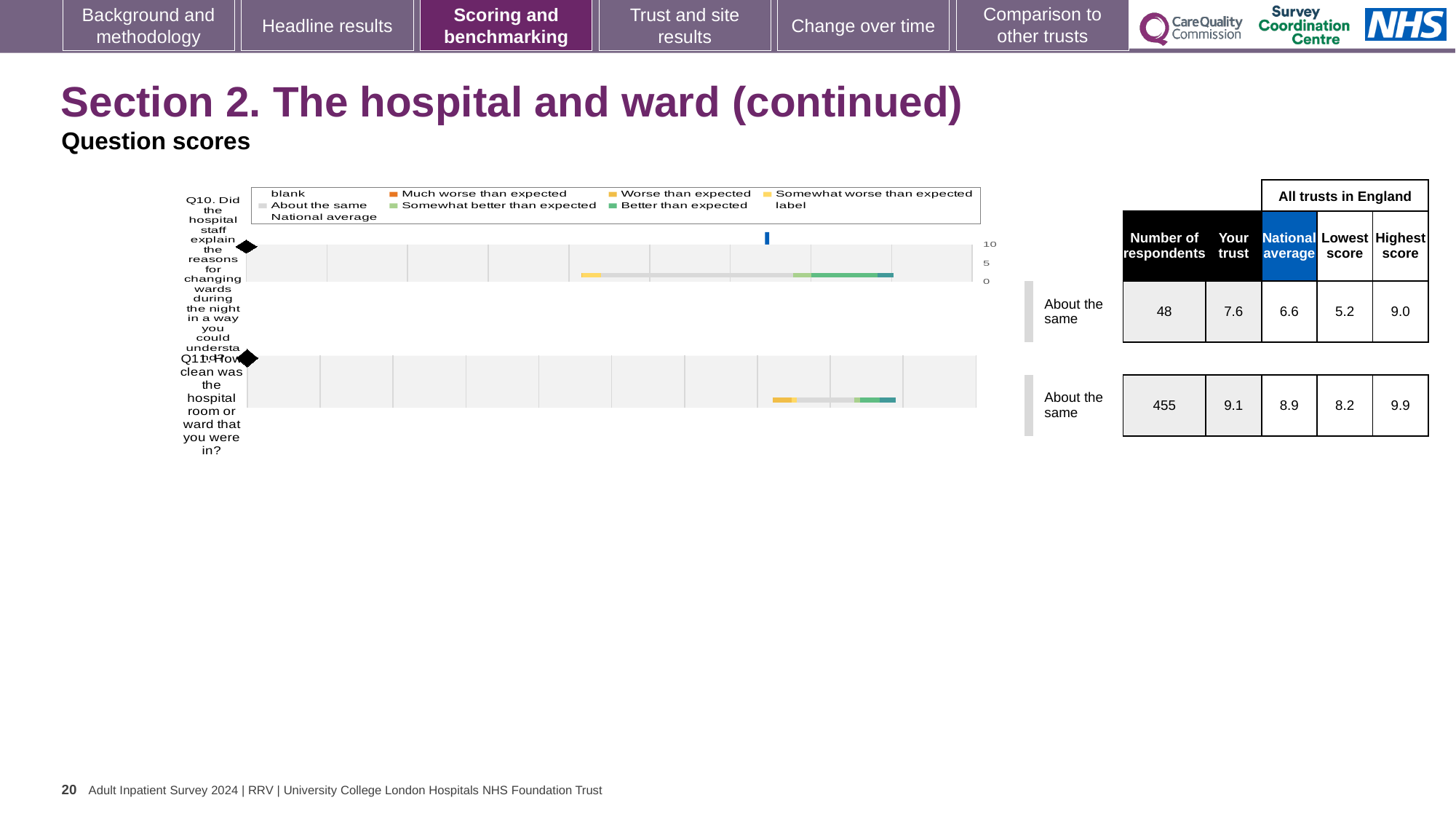
What kind of chart is used to show the question scores for Q10 and Q11? bar chart What benchmark rating is shown next to the Q11 chart? About the same Which question has the higher 'Your trust' score, Q10 or Q11? Q11 What benchmark rating is shown next to the Q10 chart? About the same How many questions (categories) are plotted on the slide's charts? 2 What is the 'Your trust' score for Q11, how clean was the hospital room or ward? 9.1 Which legend entry is shown in orange-red in the chart legend? Much worse than expected How many benchmark categories does the chart legend list, excluding 'blank', 'National average' and 'label'? 6 What is the national average score for Q11? 8.9 What is the 'Your trust' score for Q10, did staff explain the reasons for changing wards during the night? 7.6